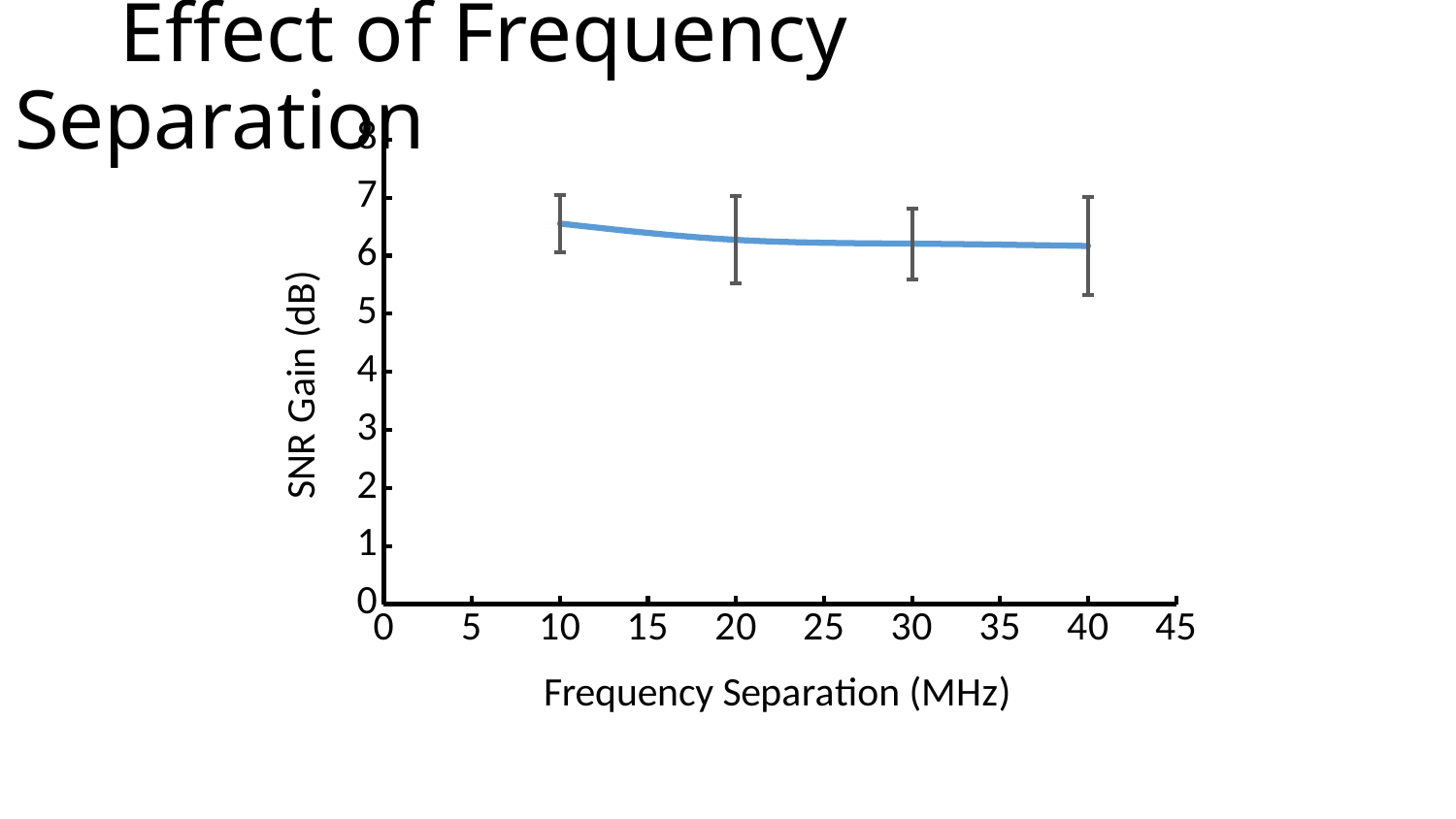
What is the label of the x axis? Frequency Separation (MHz) Is the SNR gain at a frequency separation of 20 MHz greater or less than 5 dB? greater How many data points (error-bar markers) are plotted on the line? 4 What is the label of the y axis? SNR Gain (dB) Does the SNR gain rise or fall as frequency separation increases from 10 MHz to 40 MHz? fall What kind of chart is shown on the slide? line chart Is the SNR gain at a frequency separation of 30 MHz greater or less than 7 dB? less At which frequency separation is the SNR gain highest? 10 MHz Is the SNR gain at a frequency separation of 40 MHz greater or less than 7 dB? less Which has the larger SNR gain: a frequency separation of 10 MHz or 40 MHz? 10 MHz